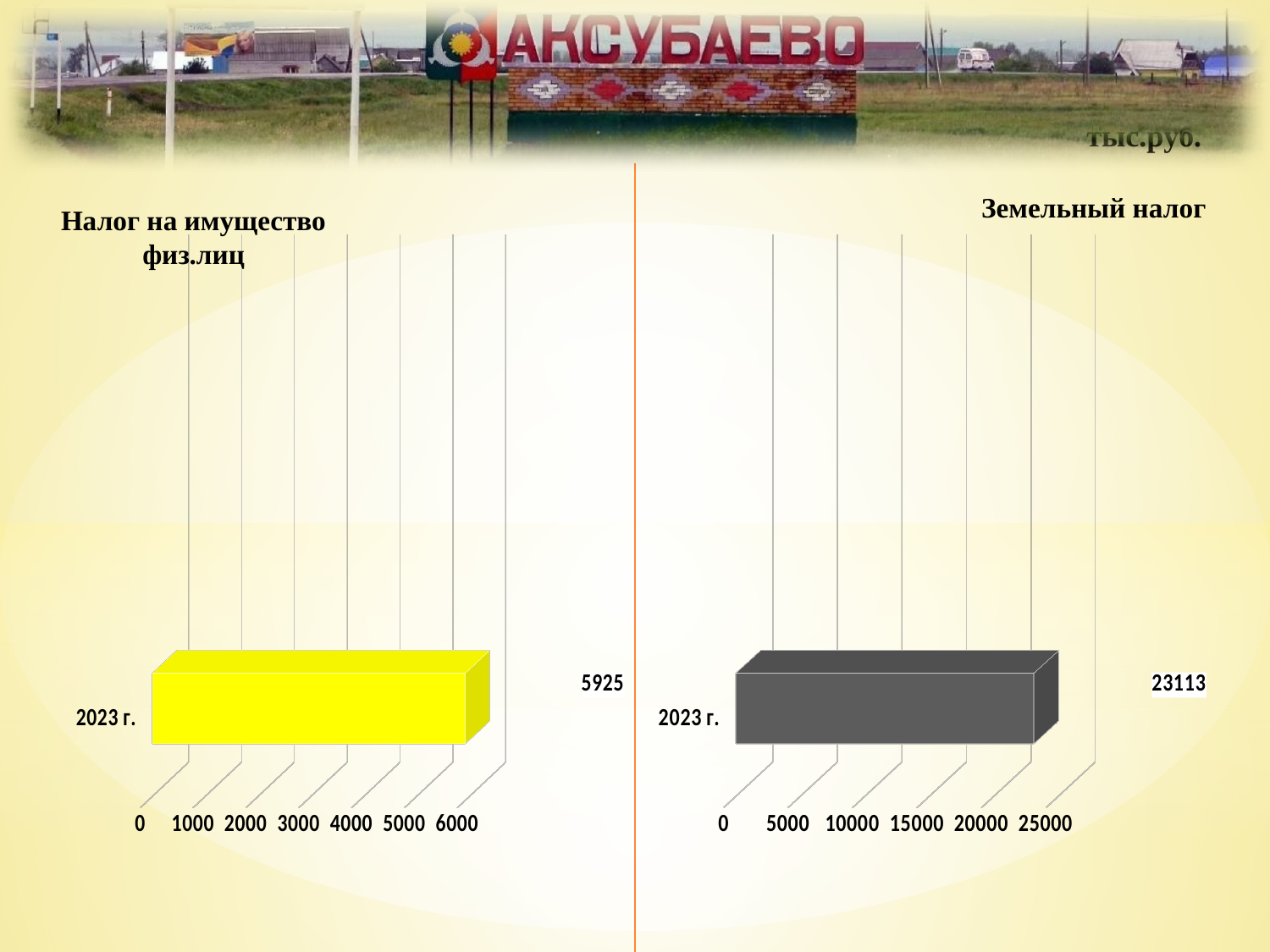
On the 'Налог на имущество физ.лиц' chart, is the value for 2023 г. greater or less than 5000? greater How many categories are plotted on the 'Земельный налог' chart? 1 What unit is shown in the top right corner of the slide for the charts? тыс.руб. On the 'Земельный налог' chart, what is the value for 2023 г.? 23113 What kind of chart is the 'Земельный налог' chart? bar chart On the 'Налог на имущество физ.лиц' chart, what is the value for 2023 г.? 5925 What kind of chart is the 'Налог на имущество физ.лиц' chart? bar chart What is the difference between the 2023 г. value on the 'Земельный налог' chart and the 2023 г. value on the 'Налог на имущество физ.лиц' chart? 17188 On the 'Земельный налог' chart, is the value for 2023 г. greater or less than 25000? less Which is larger: the 2023 г. value on the 'Земельный налог' chart or the 2023 г. value on the 'Налог на имущество физ.лиц' chart? Земельный налог What colour is the bar on the 'Налог на имущество физ.лиц' chart? yellow How many categories are plotted on the 'Налог на имущество физ.лиц' chart? 1